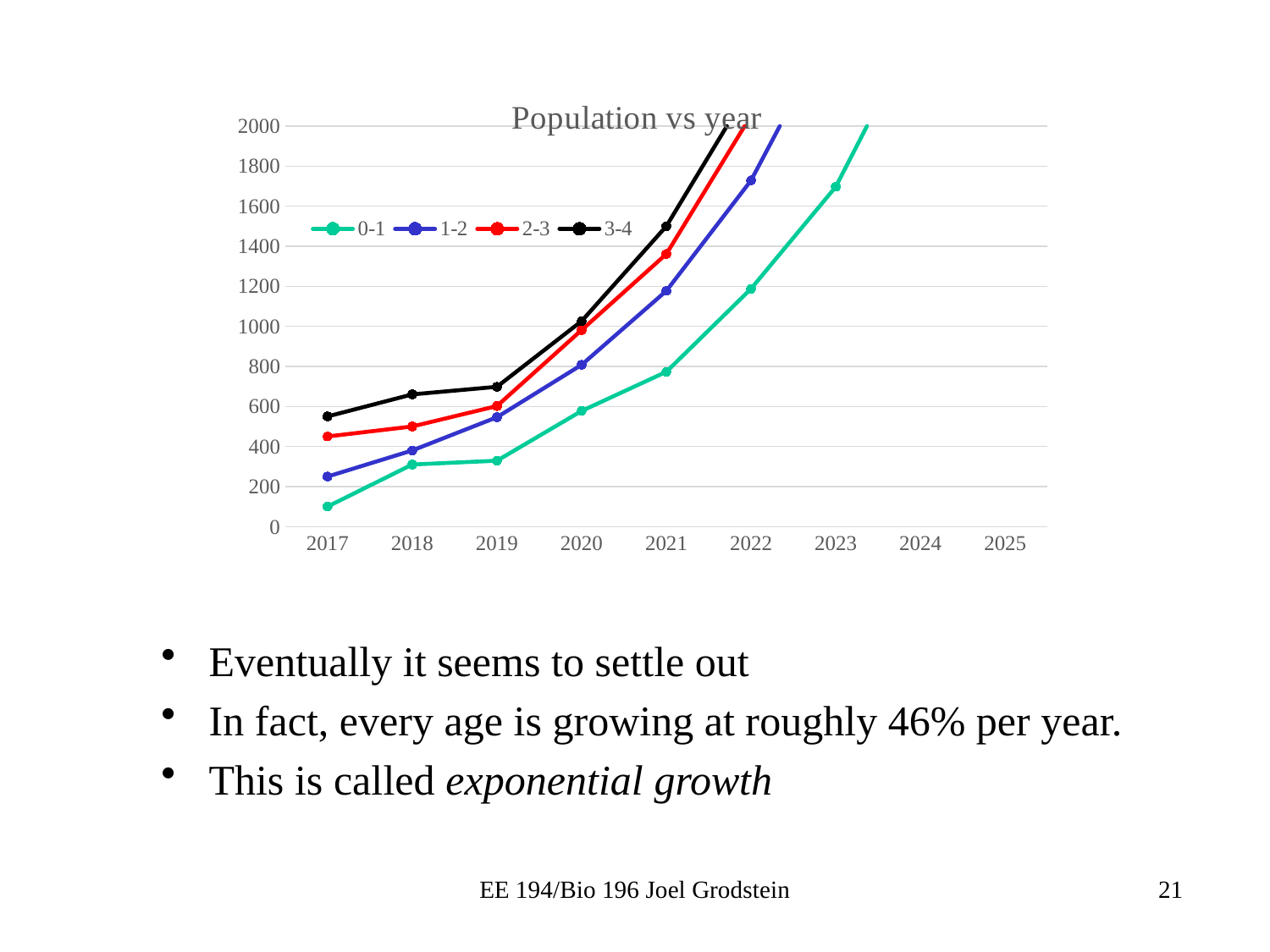
Which series has the highest value in 2017? 3-4 Is the value for the 0-1 series in 2017 greater or less than 200? less Which series has the lowest value in 2017? 0-1 How many series does the legend list? 4 What colour is the line for the 0-1 series? green In 2020, which series has the larger value, 2-3 or 1-2? 2-3 What kind of chart is shown on the slide? line chart What is the title of the chart? Population vs year How many years are labelled on the x axis? 9 Do the values of the 1-2 series rise or fall from 2017 to 2022? rise Is the value for the 0-1 series in 2022 greater or less than 1000? greater Is the value for the 3-4 series in 2021 greater or less than 1400? greater